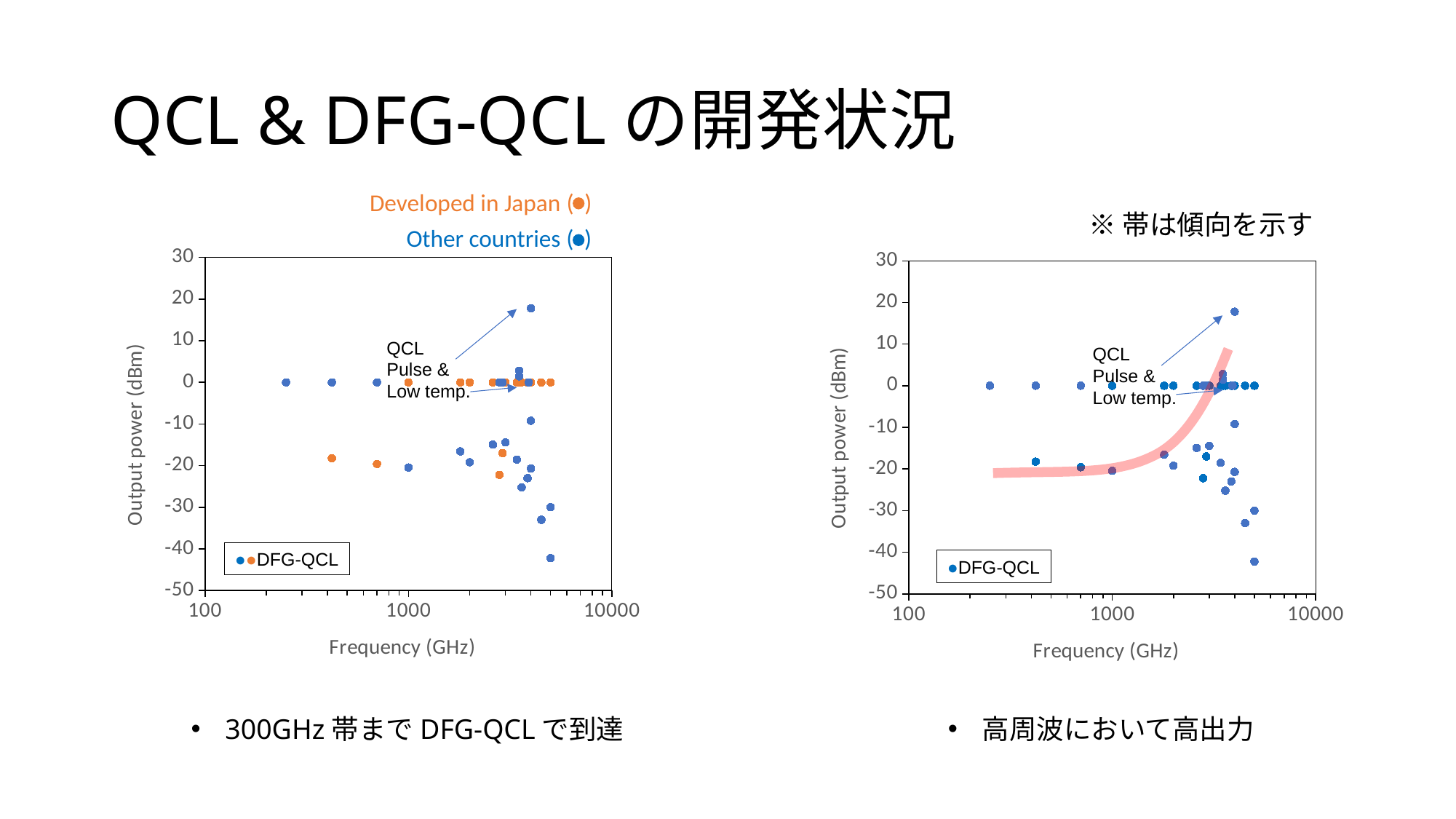
What kind of chart is the left chart on the slide? Scatter chart In the right chart, is the highest plotted point greater or less than 0 dBm? greater In the left chart, is the output power of the orange point near 400 GHz greater or less than -10 dBm? less In the right chart, is the output power of the point near 250 GHz greater or less than -10 dBm? greater In the left chart, what does the orange dot colour represent according to the text above the chart? Developed in Japan What kind of chart is the right chart on the slide? Scatter chart In the right chart, what is the label of the x axis? Frequency (GHz) In the left chart, what is the label of the y axis? Output power (dBm) In the left chart, what series name is shown in the legend? DFG-QCL